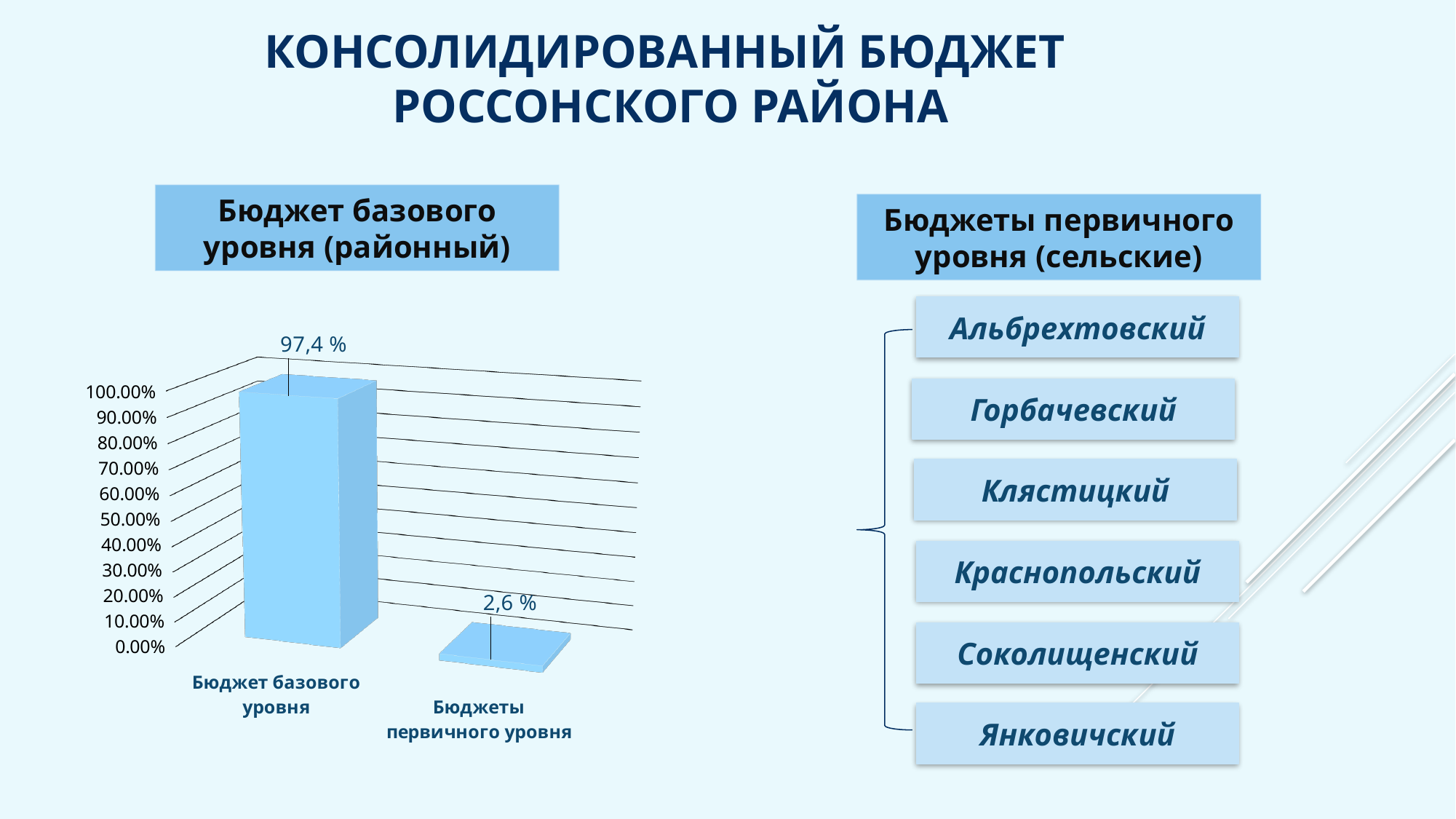
What is the value shown for Бюджеты первичного уровня? 2,6 % What is the value shown for Бюджет базового уровня? 97,4 % What is the highest tick value on the vertical axis of the chart? 100.00% What kind of chart is shown on the slide? bar chart How many categories are plotted in the chart? 2 What is the difference between the values for Бюджет базового уровня and Бюджеты первичного уровня? 94,8 % Is the value for Бюджеты первичного уровня greater or less than 10.00%? less How many сельские (rural) budgets are listed on the right side of the slide? 6 Which category has the highest value in the chart? Бюджет базового уровня Is the value for Бюджет базового уровня greater or less than 90.00%? greater Which is larger: the value for Бюджет базового уровня or for Бюджеты первичного уровня? Бюджет базового уровня Which category has the lowest value in the chart? Бюджеты первичного уровня